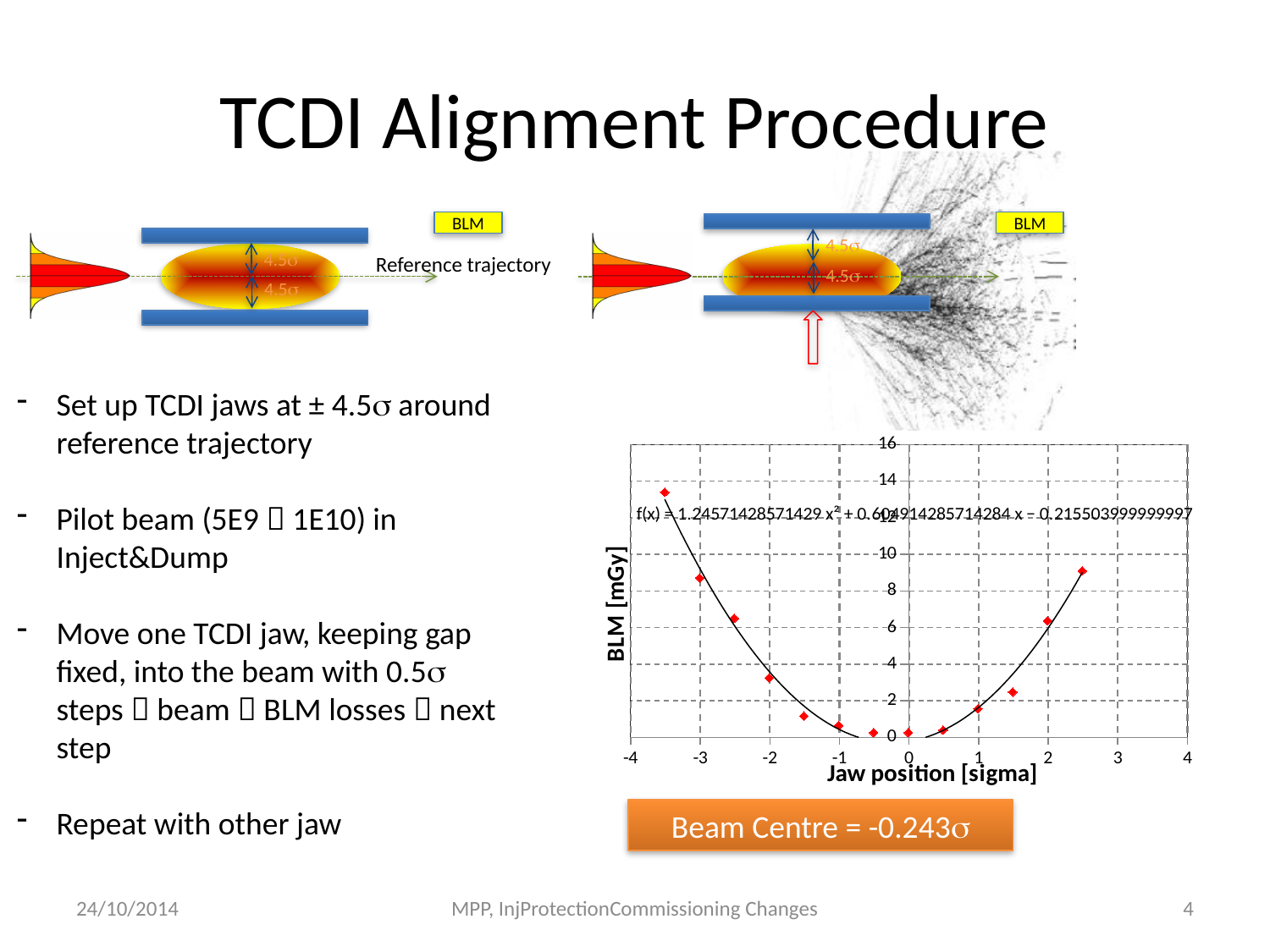
How many data points are plotted on the chart? 13 Do the BLM values rise or fall as the jaw position goes from 0 to 2.5? rise What kind of chart is shown on the slide? scatter chart What is the title of the x axis of the chart? Jaw position [sigma] Is the BLM value at jaw position 2.5 greater or less than 8? greater Is the BLM value at jaw position 1.5 greater or less than 4? less Is the BLM value at jaw position -2 greater or less than 4? less Which has the larger BLM value: jaw position -3.5 or jaw position 2.5? -3.5 What is the title of the y axis of the chart? BLM [mGy] Which has the larger BLM value: jaw position -2 or jaw position 2? 2 At which jaw position is the BLM value highest? -3.5